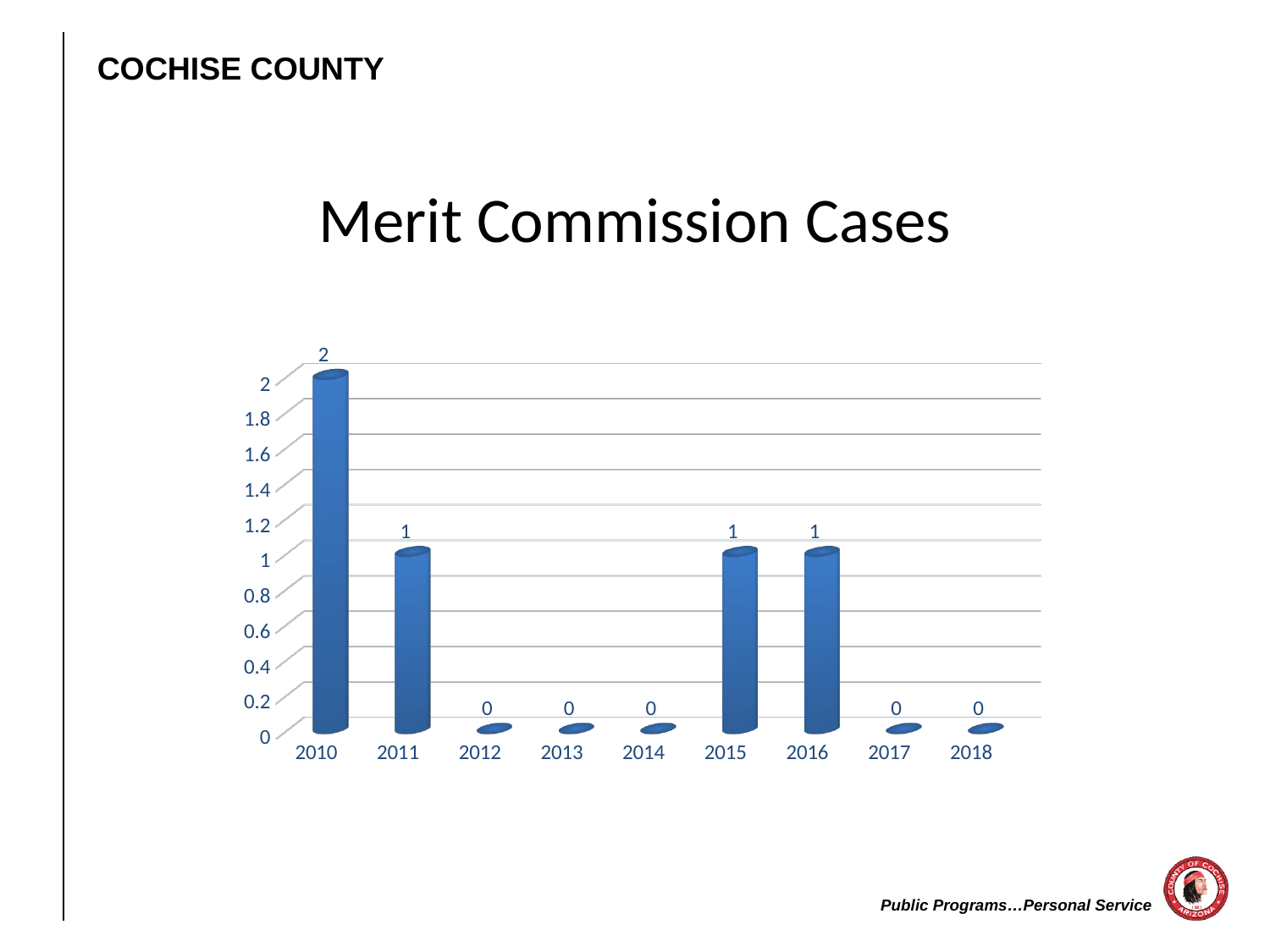
What is the difference between the values for 2010 and 2011? 1 What is the value for 2015? 1 What is the difference between the values for 2010 and 2012? 2 What is the title of the chart? Merit Commission Cases Which is larger, the value for 2016 or the value for 2017? 2016 What is the value for 2018? 0 How many years are shown on the x axis? 9 How many years have a value of 0? 5 What is the value for 2013? 0 What is the value for 2010? 2 What kind of chart is this? Bar chart Which year has the highest value? 2010